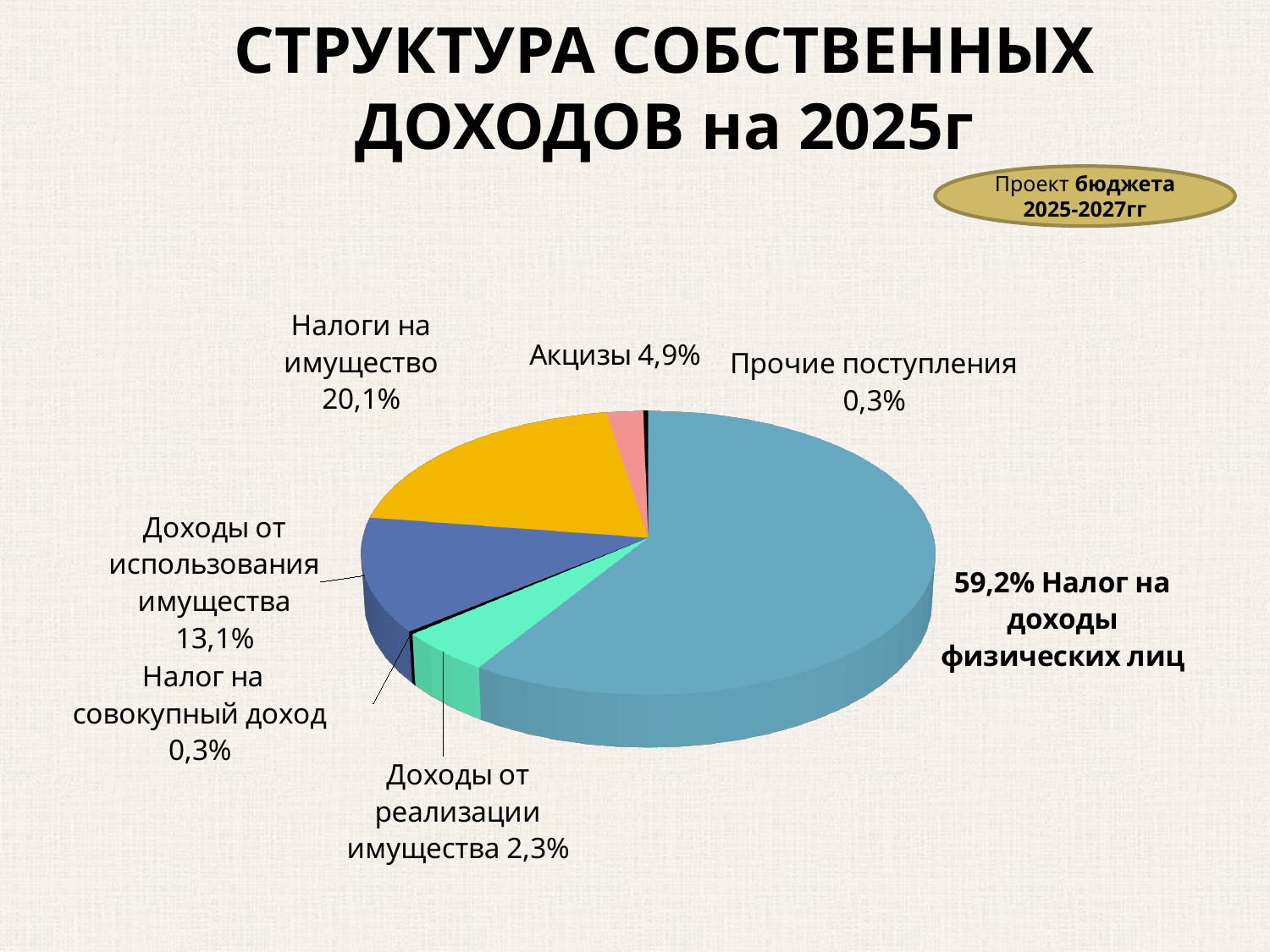
What is the value shown for "Налоги на имущество"? 20,1% What is the value shown for "Доходы от реализации имущества"? 2,3% What is the value shown for "Доходы от использования имущества"? 13,1% Which category has the largest share of the pie? Налог на доходы физических лиц What is the value shown for "Акцизы"? 4,9% What share of own revenues does "Налог на доходы физических лиц" account for? 59,2% What kind of chart is shown on the slide? pie chart What is the title of the slide containing the chart? СТРУКТУРА СОБСТВЕННЫХ ДОХОДОВ на 2025г What is the difference between the shares of "Налоги на имущество" and "Акцизы"? 15,2% What is the combined share of "Прочие поступления" and "Налог на совокупный доход"? 0,6% How many slices does the pie chart have? 7 Which is larger, "Налоги на имущество" or "Доходы от использования имущества"? Налоги на имущество